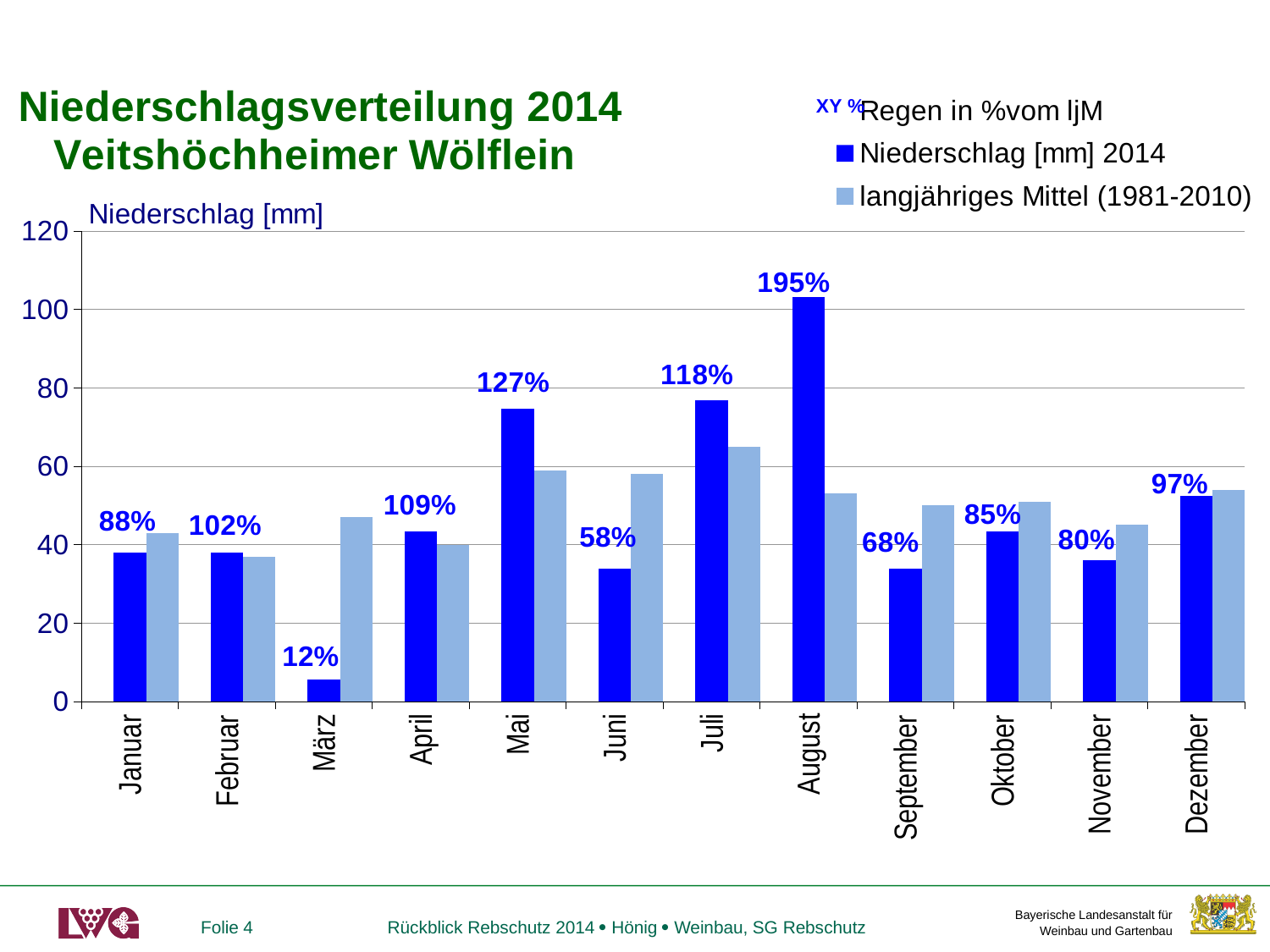
Is the Niederschlag [mm] 2014 value for März greater or less than 20? less What percentage label is shown for August? 195% Which month has the lowest percentage label? März Is the Niederschlag [mm] 2014 value for August greater or less than 100? greater What is the difference between the percentage labels for Mai and Juli? 9% In März, which bar is taller: Niederschlag [mm] 2014 or langjähriges Mittel (1981-2010)? langjähriges Mittel (1981-2010) What percentage label is shown for Juni? 58% What type of chart is shown on the slide? bar chart What percentage label is shown for März? 12% Which month has the highest percentage label? August Which month has the larger percentage label, Mai or Juli? Mai How many months are shown on the x axis? 12